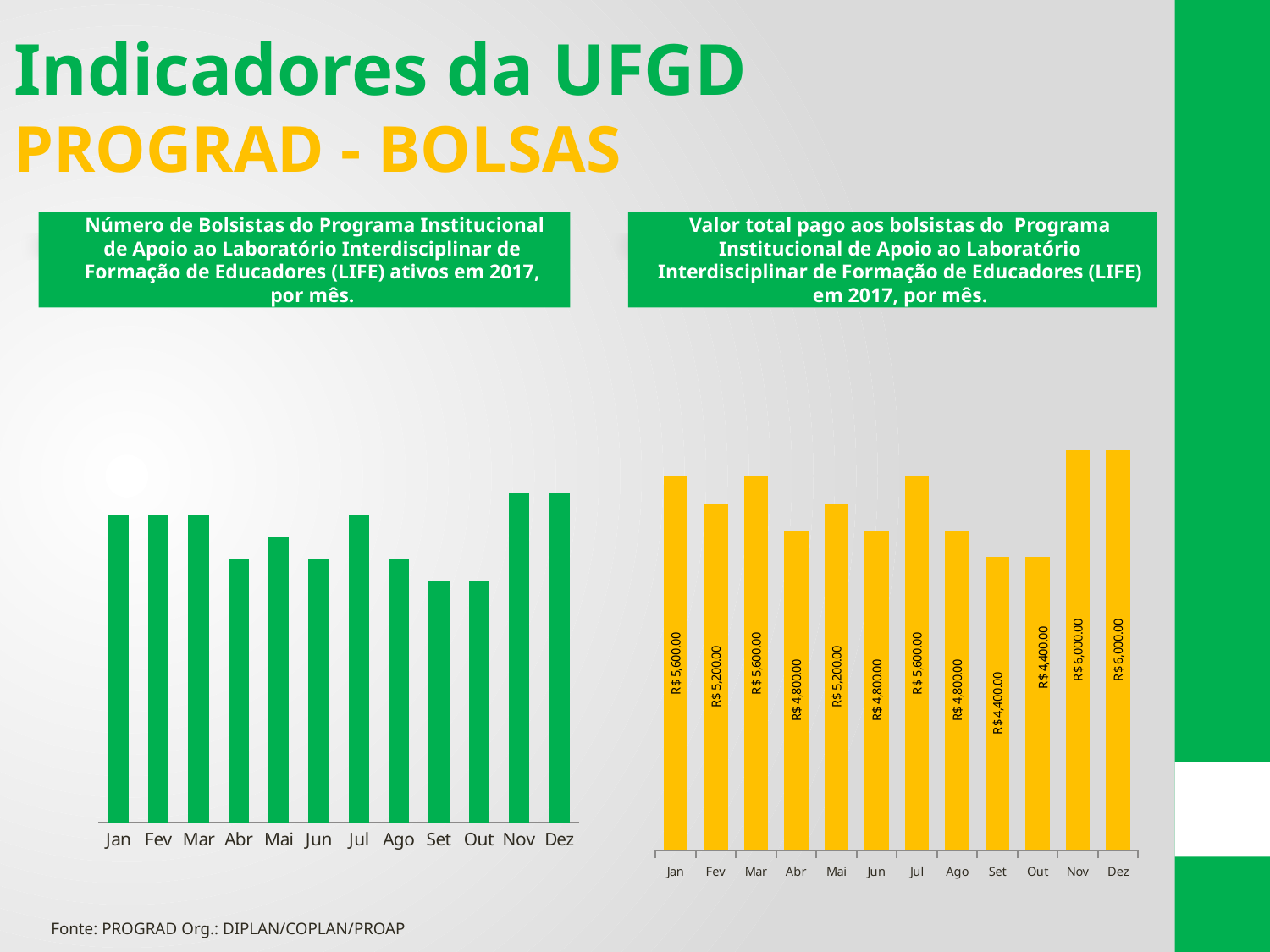
In the right chart (Valor total pago aos bolsistas), which months have the lowest value? Set and Out In the right chart (Valor total pago aos bolsistas), how many months are plotted? 12 In the right chart (Valor total pago aos bolsistas), what is the value for Abr? R$ 4,800.00 In the left chart (Número de Bolsistas), which is larger, the bar for Nov or the bar for Set? Nov In the right chart (Valor total pago aos bolsistas), which is larger, the value for Jan or the value for Fev? Jan In the right chart (Valor total pago aos bolsistas), what is the value for Nov? R$ 6,000.00 In the right chart (Valor total pago aos bolsistas), which months have the highest value? Nov and Dez In the right chart (Valor total pago aos bolsistas), what is the difference between the values for Nov and Set? R$ 1,600.00 What type of chart is the left chart (Número de Bolsistas)? Bar chart In the right chart (Valor total pago aos bolsistas), what is the value for Set? R$ 4,400.00 In the left chart (Número de Bolsistas), how many months are plotted? 12 In the right chart (Valor total pago aos bolsistas), what is the value for Jan? R$ 5,600.00